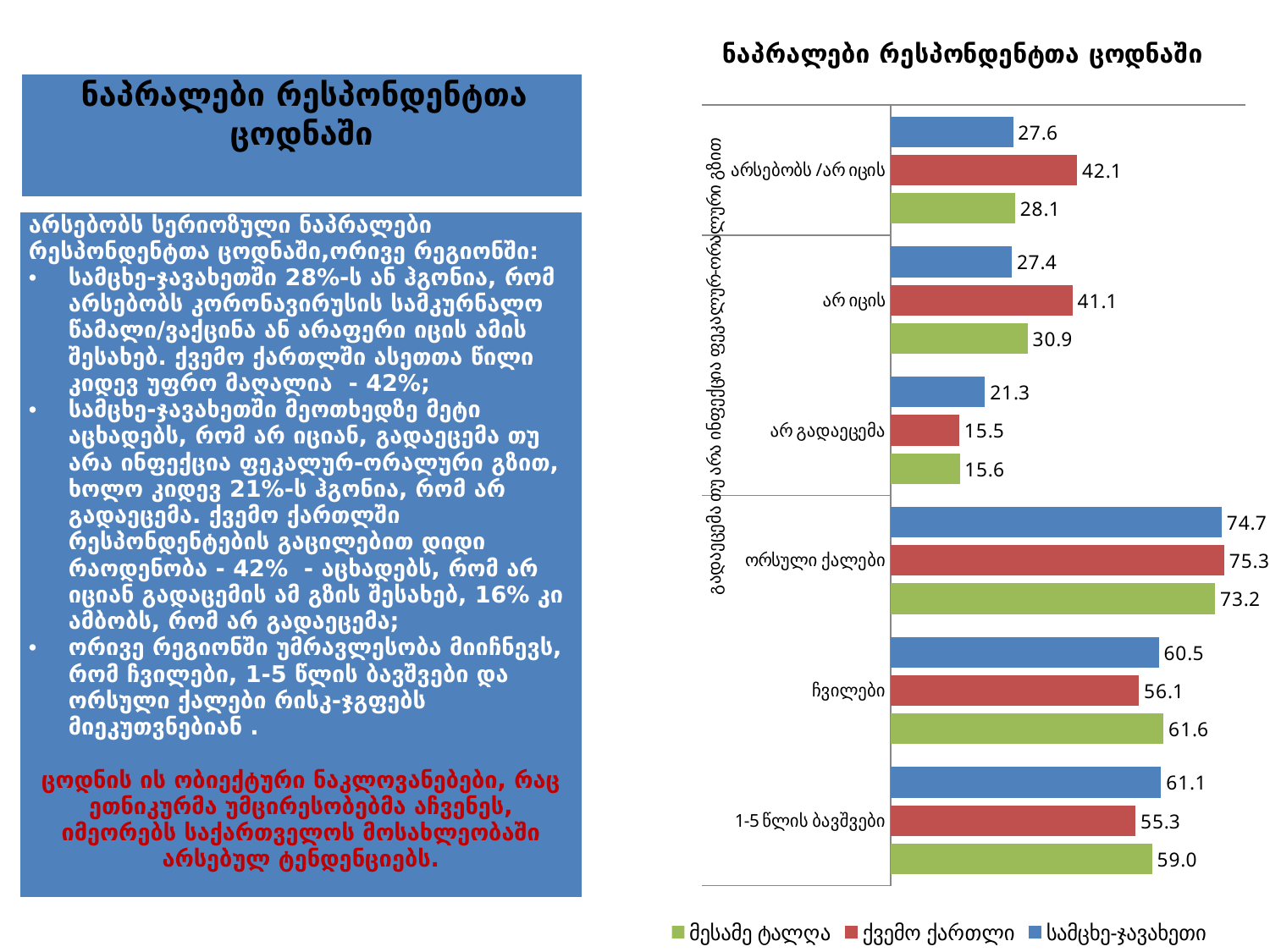
What is the value for ქვემო ქართლი in the category არსებობს /არ იცის? 42.1 What is the title of the chart? ნაპრალები რესპონდენტთა ცოდნაში What is the value for სამცხე-ჯავახეთი in the category ორსული ქალები? 74.7 How many series does the legend list? 3 In the category ჩვილები, which is larger: the value for მესამე ტალღა or the value for ქვემო ქართლი? მესამე ტალღა What is the value for ქვემო ქართლი in the category არ გადაეცემა? 15.5 What is the difference between the ქვემო ქართლი and სამცხე-ჯავახეთი values in the category არ იცის? 13.7 What is the value for მესამე ტალღა in the category 1-5 წლის ბავშვები? 59.0 What type of chart is shown on the slide? bar chart How many categories are shown on the chart? 6 Which category has the highest value for ქვემო ქართლი? ორსული ქალები Which category has the lowest value for სამცხე-ჯავახეთი? არ გადაეცემა